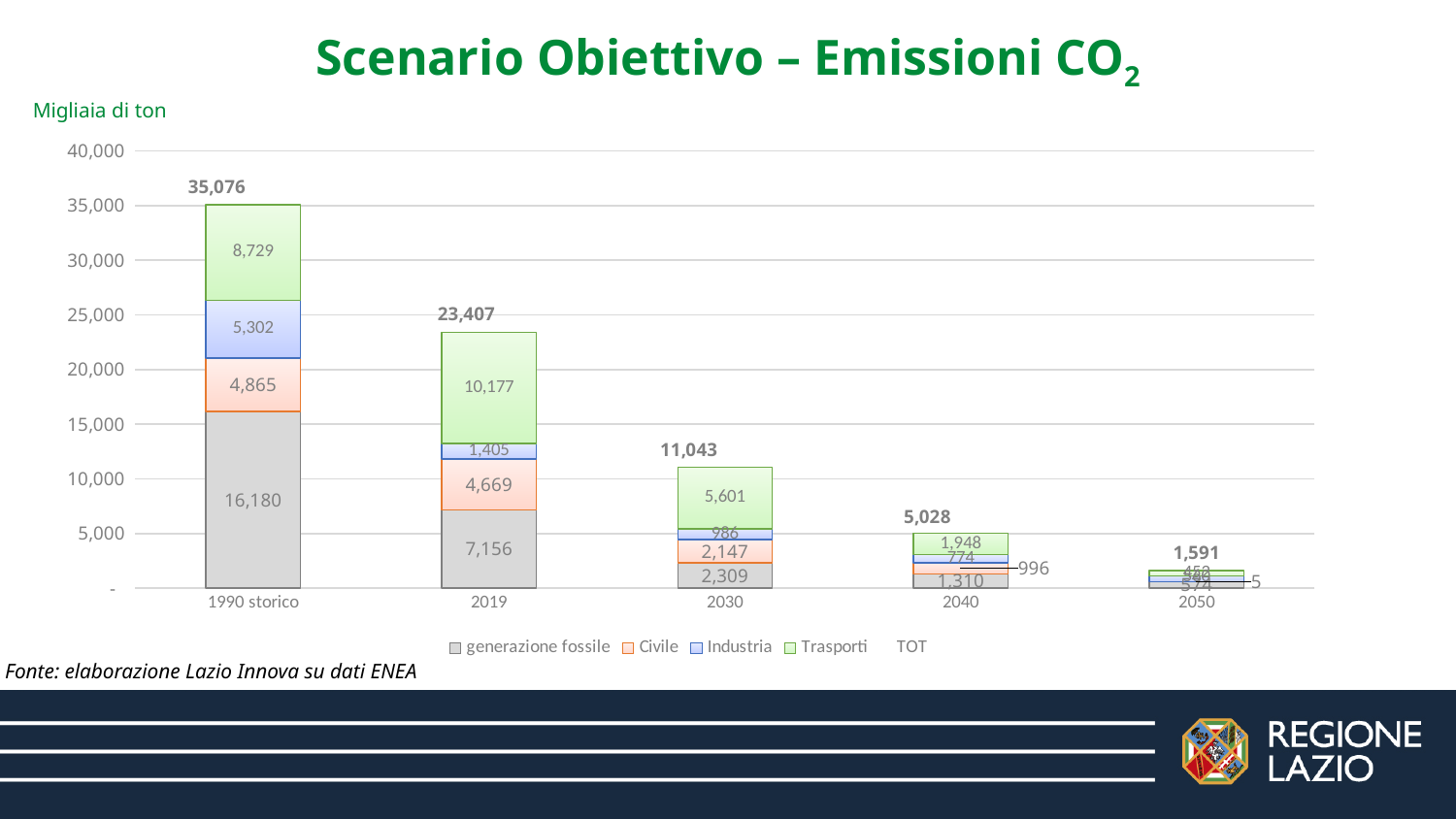
What is the total value shown for 2050? 1,591 What type of chart is shown on the slide? stacked bar chart Do the total emissions rise or fall from 1990 storico to 2050? fall Which year has the highest total emissions? 1990 storico What is the value of Civile in 2030? 2,147 What is the value of generazione fossile in 1990 storico? 16,180 Which year has the lowest total emissions? 2050 Which is larger: Trasporti in 2019 or Trasporti in 1990 storico? Trasporti in 2019 What is the value of Trasporti in 2019? 10,177 What is the total CO2 emissions value shown for 1990 storico? 35,076 What is the difference between the total for 2019 and the total for 2030? 12,364 How many years (categories) are shown on the x axis? 5